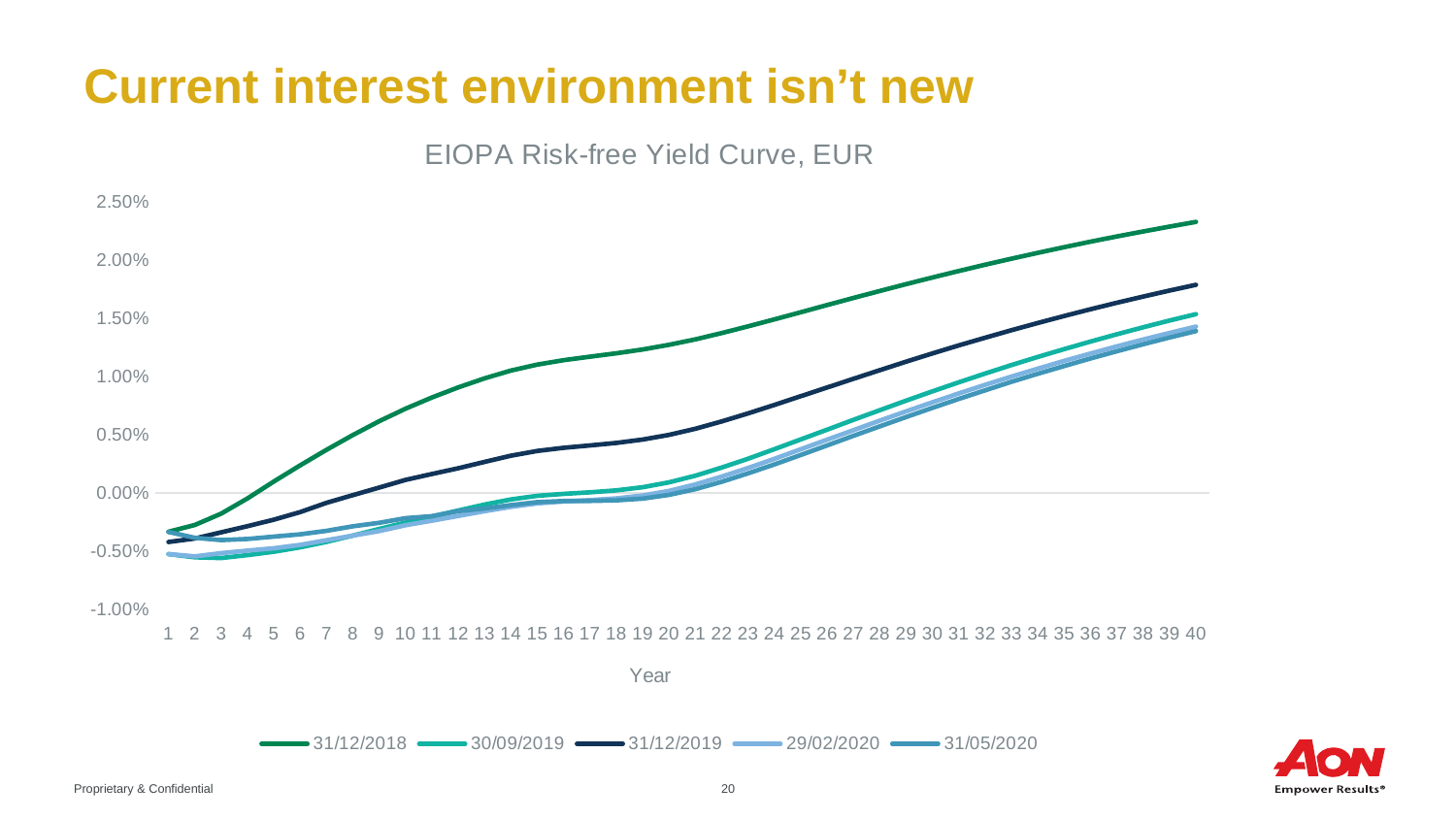
What kind of chart is shown on the slide? line chart How many years are shown along the x axis? 40 What is the label of the x axis? Year Is the value for the 31/12/2019 series at year 40 greater or less than 2.00%? less How many series does the legend list? 5 Which series has the highest value at year 40? 31/12/2018 What is the title of the chart? EIOPA Risk-free Yield Curve, EUR At year 20, which series has the larger value, 31/12/2018 or 31/12/2019? 31/12/2018 Is the value for the 31/12/2019 series at year 20 greater or less than 1.00%? less Do the values of the 31/12/2018 series rise or fall as the year increases? rise Is the value for the 31/12/2018 series at year 40 greater or less than 2.00%? greater